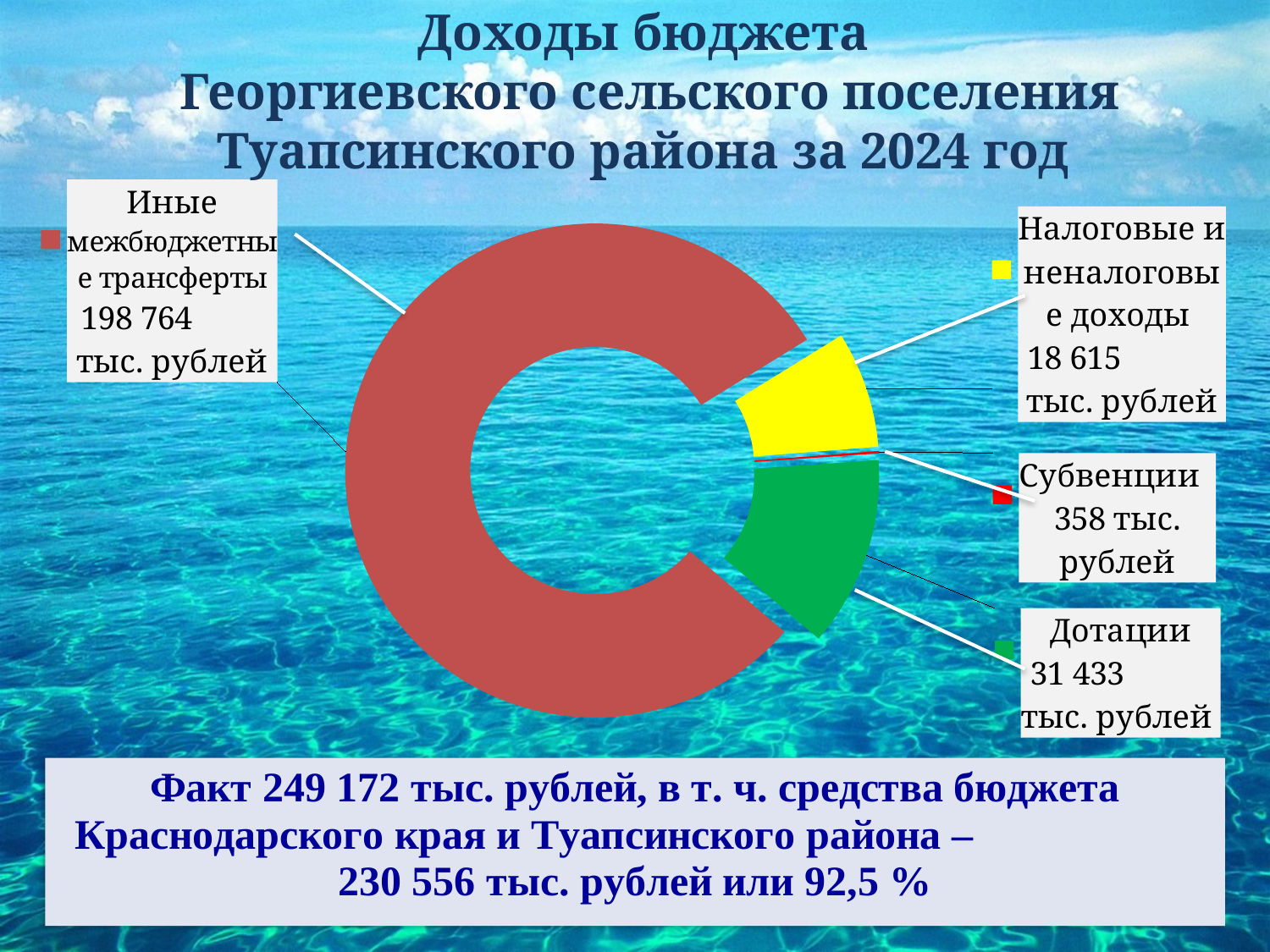
What is the value for "Налоговые и неналоговые доходы"? 18 615 тыс. рублей What is the difference between "Иные межбюджетные трансферты" and "Дотации"? 167 331 тыс. рублей What is the difference between "Дотации" and "Налоговые и неналоговые доходы"? 12 818 тыс. рублей Which is larger: "Дотации" or "Налоговые и неналоговые доходы"? Дотации What type of chart is shown on the slide? doughnut chart Which category has the smallest value? Субвенции What is the value for "Дотации"? 31 433 тыс. рублей Which category has the largest value? Иные межбюджетные трансферты What colour is the segment for "Дотации"? green How many categories does the chart show? 4 What is the value for "Субвенции"? 358 тыс. рублей What is the value for "Иные межбюджетные трансферты"? 198 764 тыс. рублей